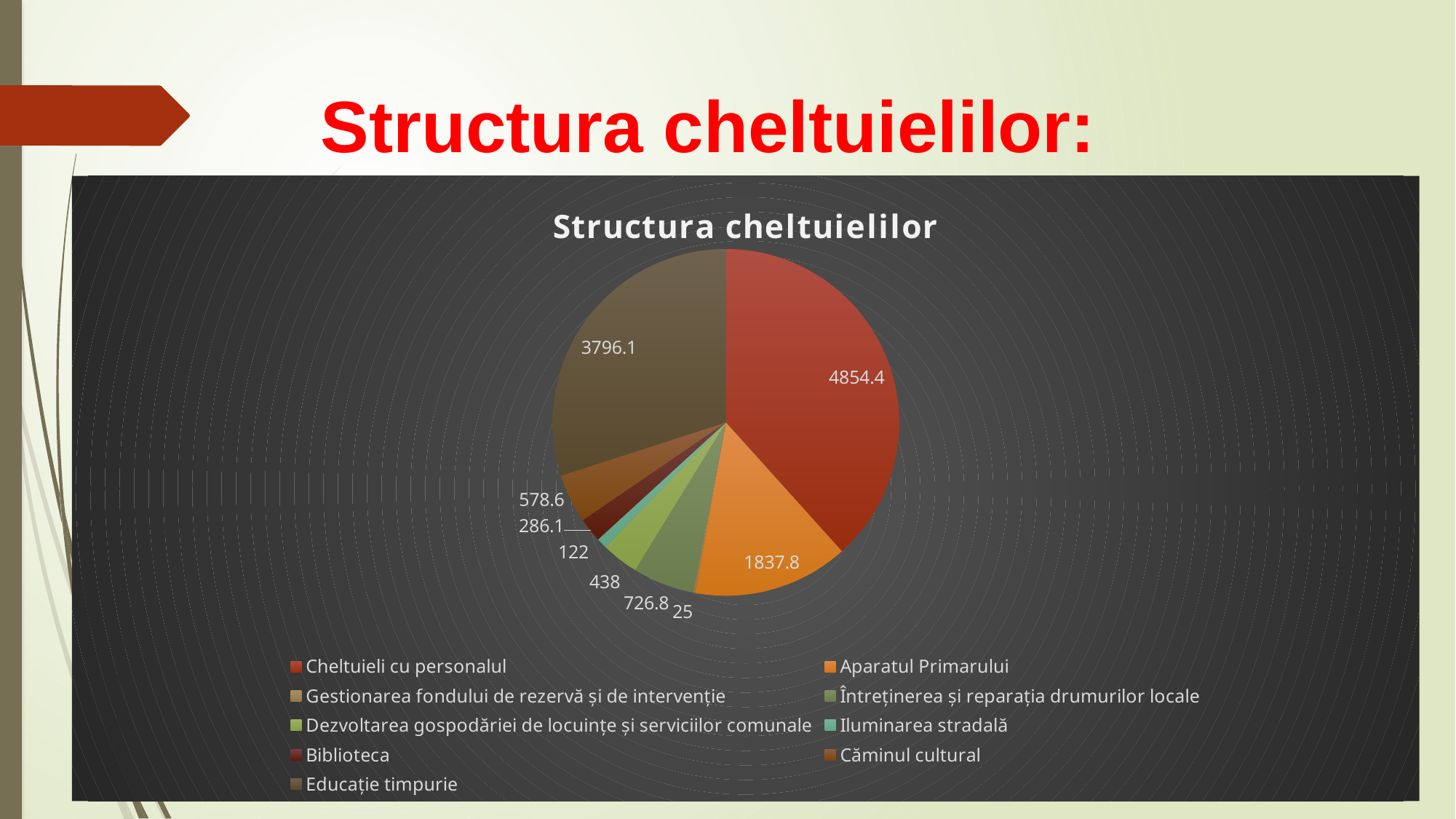
How many categories does the pie chart have? 9 Which is larger, the value for Biblioteca or the value for Căminul cultural? Căminul cultural What is the value for Educație timpurie? 3796.1 Which category has the smallest slice of the pie? Gestionarea fondului de rezervă și de intervenție What is the value for Cheltuieli cu personalul? 4854.4 What is the value for Căminul cultural? 578.6 What is the value for Aparatul Primarului? 1837.8 What is the difference between the values for Cheltuieli cu personalul and Educație timpurie? 1058.3 Which category has the largest slice of the pie? Cheltuieli cu personalul What is the value for Iluminarea stradală? 122 What type of chart is shown on the slide? pie chart What is the title of the chart? Structura cheltuielilor